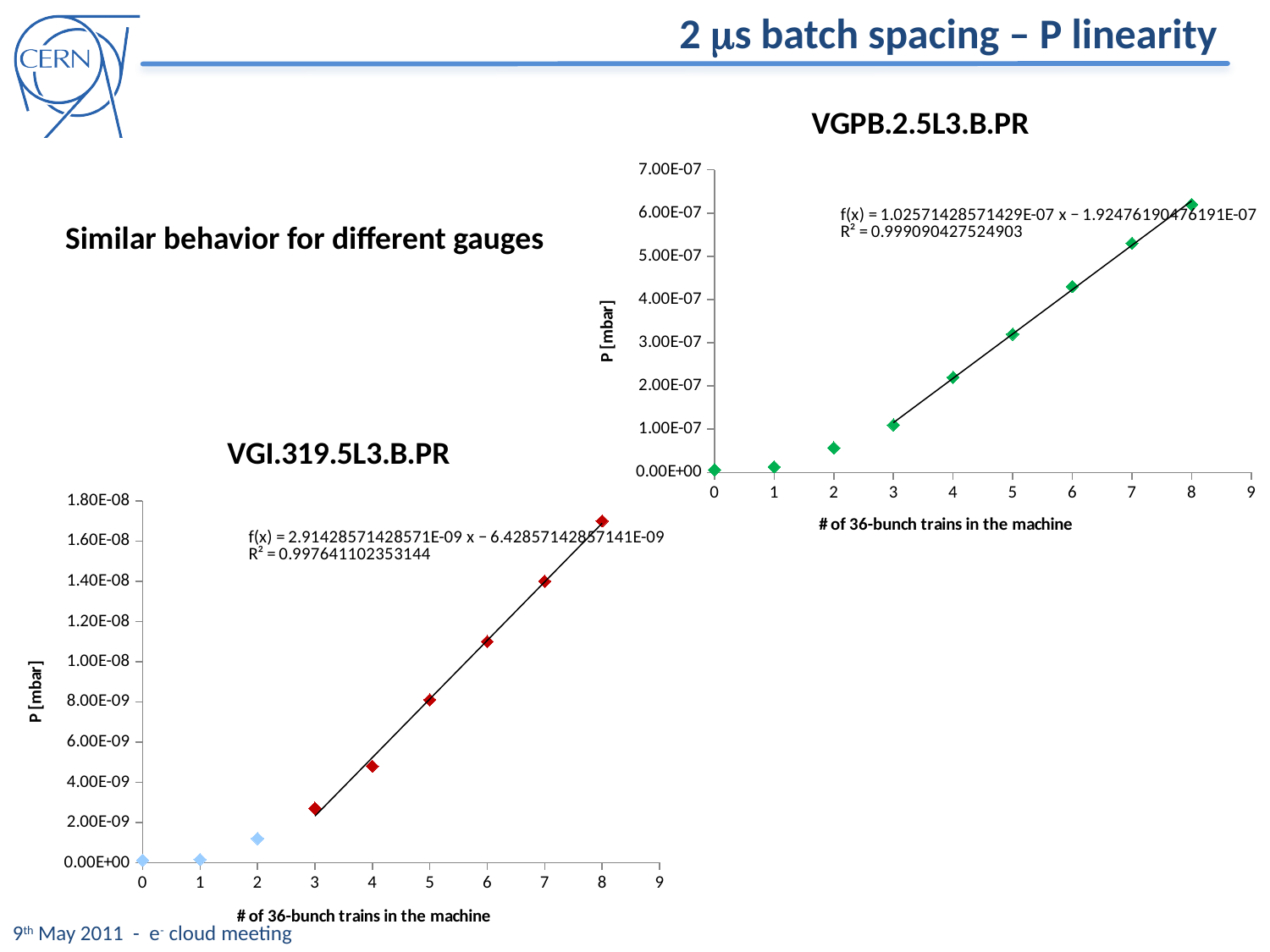
What kind of chart is the VGI.319.5L3.B.PR chart? scatter chart What is the x-axis label of the VGI.319.5L3.B.PR chart? # of 36-bunch trains in the machine In the VGPB.2.5L3.B.PR chart, do the pressure values rise or fall as the number of 36-bunch trains increases? rise In the VGI.319.5L3.B.PR chart, how many data points are plotted? 9 In the VGI.319.5L3.B.PR chart, is the pressure at 6 trains greater or less than 1.00E-08? greater In the VGPB.2.5L3.B.PR chart, at which number of 36-bunch trains is the pressure lowest? 0 In the VGI.319.5L3.B.PR chart, is the pressure at 2 trains greater or less than 2.00E-09? less In the VGPB.2.5L3.B.PR chart, is the pressure at 2 trains greater or less than 1.00E-07? less In the VGPB.2.5L3.B.PR chart, how many data points are plotted? 9 In the VGI.319.5L3.B.PR chart, at which number of 36-bunch trains is the pressure highest? 8 What kind of chart is the VGPB.2.5L3.B.PR chart? scatter chart